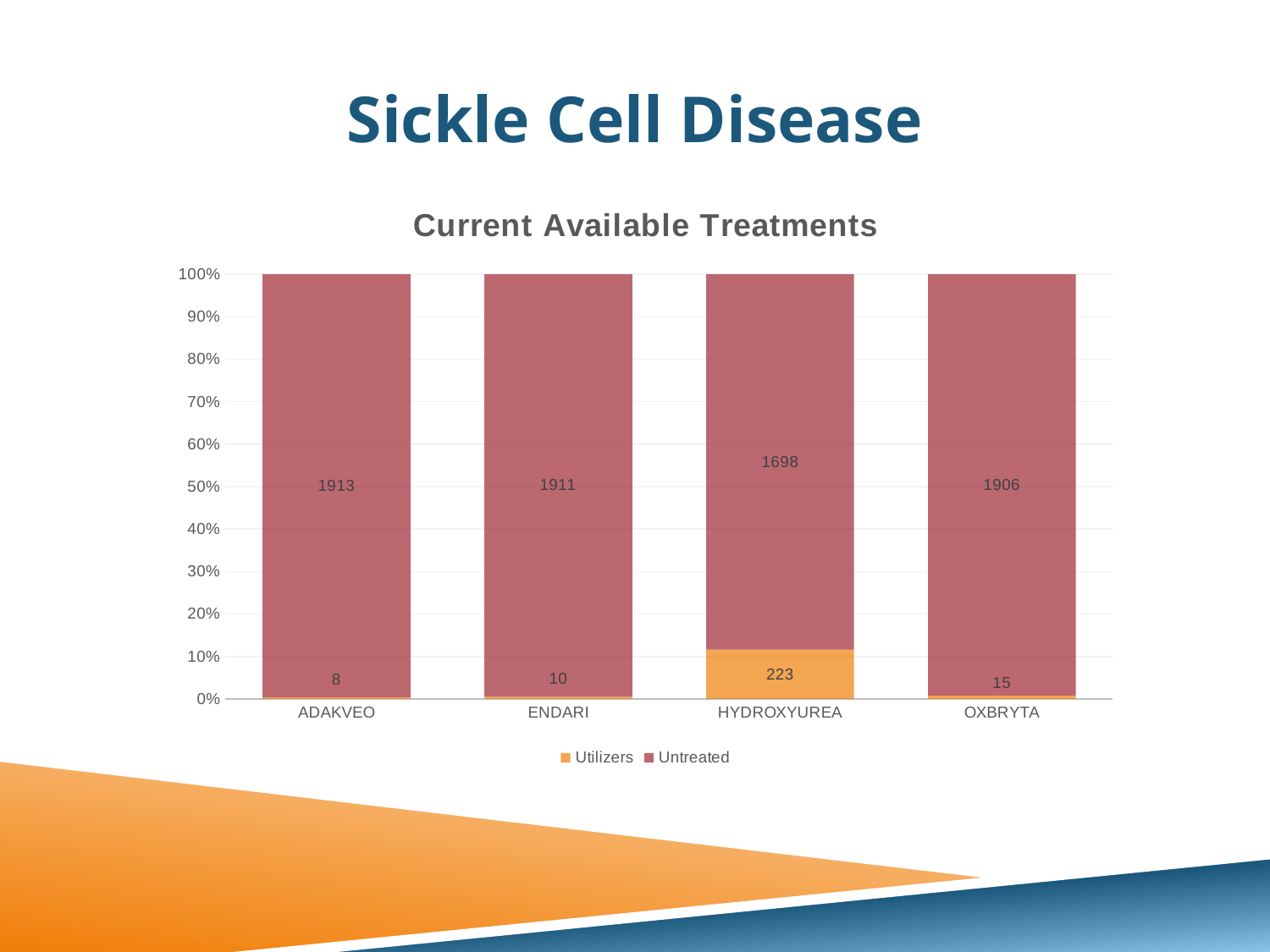
What is the difference between the Utilizers values for HYDROXYUREA and ENDARI? 213 What is the Utilizers value for OXBRYTA? 15 Which is larger, the Untreated value for ENDARI or for OXBRYTA? ENDARI Which treatment has the lowest Untreated value? HYDROXYUREA How many treatments are shown on the x axis? 4 What is the total of Utilizers and Untreated for HYDROXYUREA? 1921 Which treatment has the highest Utilizers value? HYDROXYUREA What is the Utilizers value for HYDROXYUREA? 223 What is the Untreated value for ADAKVEO? 1913 What kind of chart is shown? Stacked bar chart How many series does the legend list? 2 Which treatment has the lowest Utilizers value? ADAKVEO